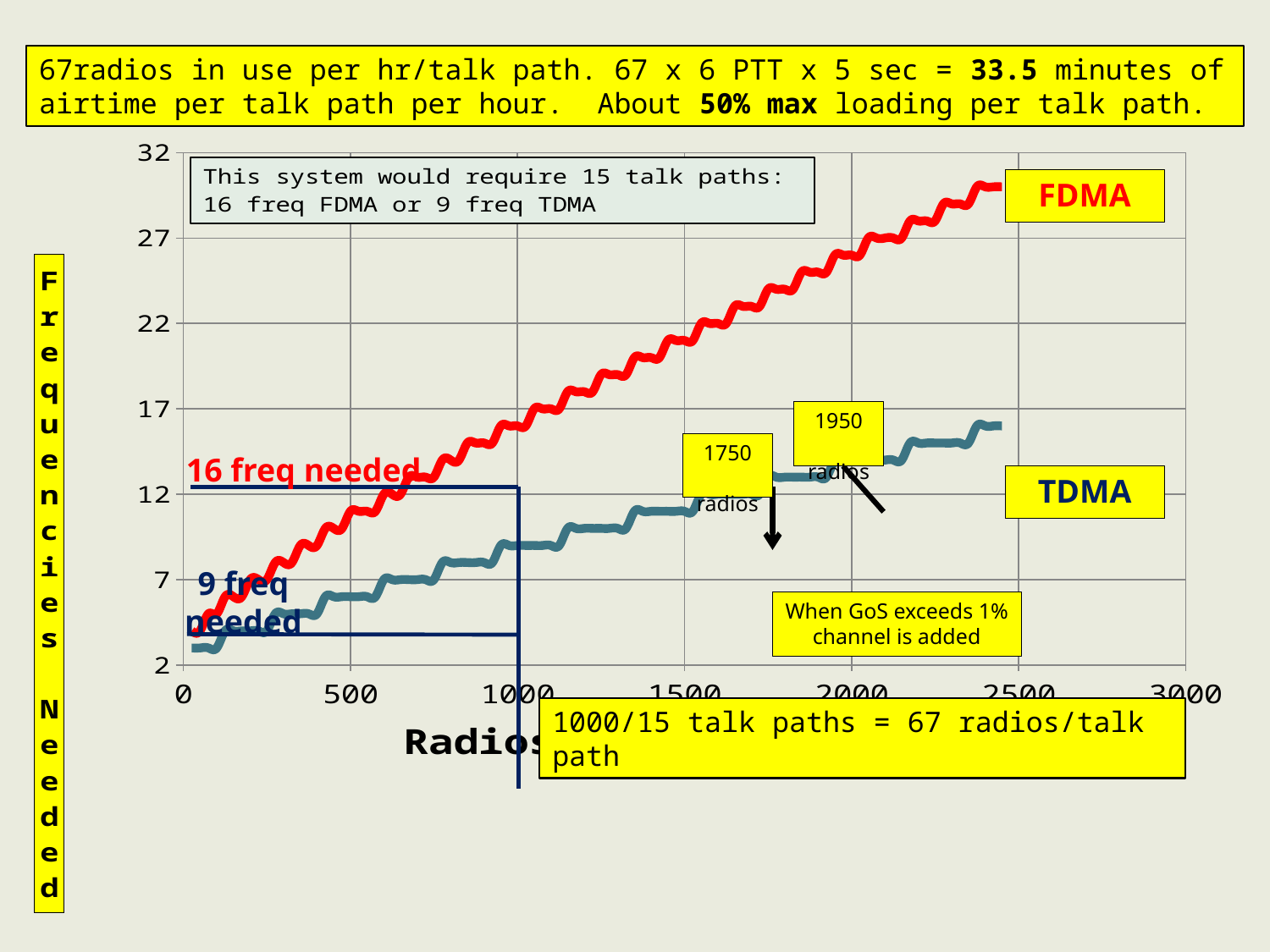
According to the chart annotation, how many frequencies are needed for TDMA at 1000 radios? 9 Do the frequencies needed rise or fall as the number of radios increases? rise What colour is the FDMA line? red At 1000 radios, which needs more frequencies, FDMA or TDMA? FDMA Is the TDMA value at 2000 radios greater or less than 17? less What kind of chart is shown on the slide? line chart Which series requires the higher number of frequencies across the chart, FDMA or TDMA? FDMA Is the FDMA value at 2000 radios greater or less than 22? greater According to the chart annotation, how many frequencies are needed for FDMA at 1000 radios? 16 How many series (lines) are plotted on the chart? 2 What is the label of the x axis? Radios At 1000 radios, how many more frequencies does FDMA need than TDMA? 7